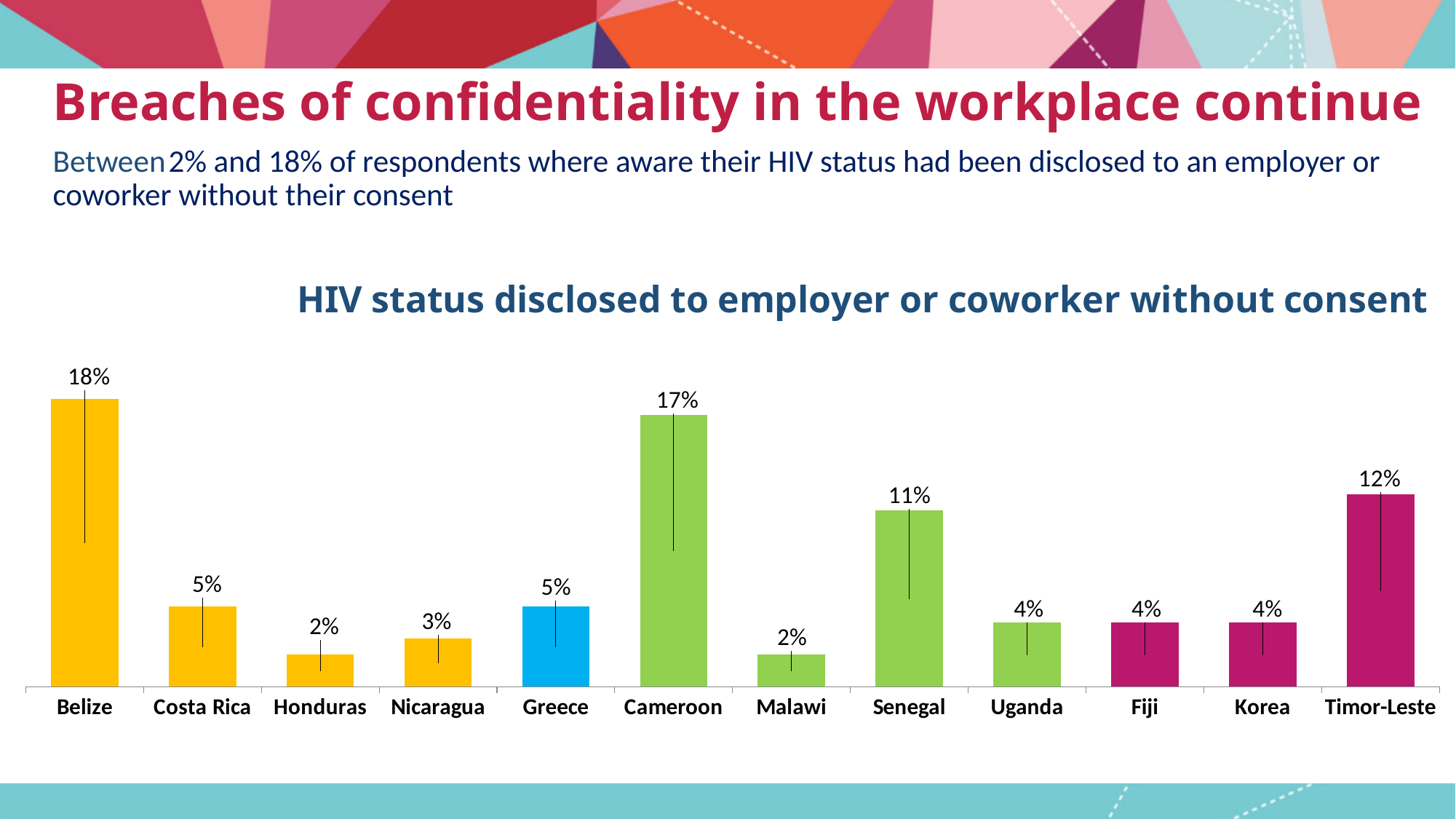
What kind of chart is shown on the slide? Bar chart What is the value for Timor-Leste? 12% What is the value for Belize? 18% What is the value for Senegal? 11% Which country has the highest value? Belize What is the difference between the values for Timor-Leste and Senegal? 1% Which is larger, the value for Greece or the value for Nicaragua? Greece Which is larger, the value for Senegal or the value for Uganda? Senegal What is the difference between the values for Belize and Cameroon? 1% How many countries are shown in the chart? 12 What is the value for Cameroon? 17% What is the title of the chart? HIV status disclosed to employer or coworker without consent